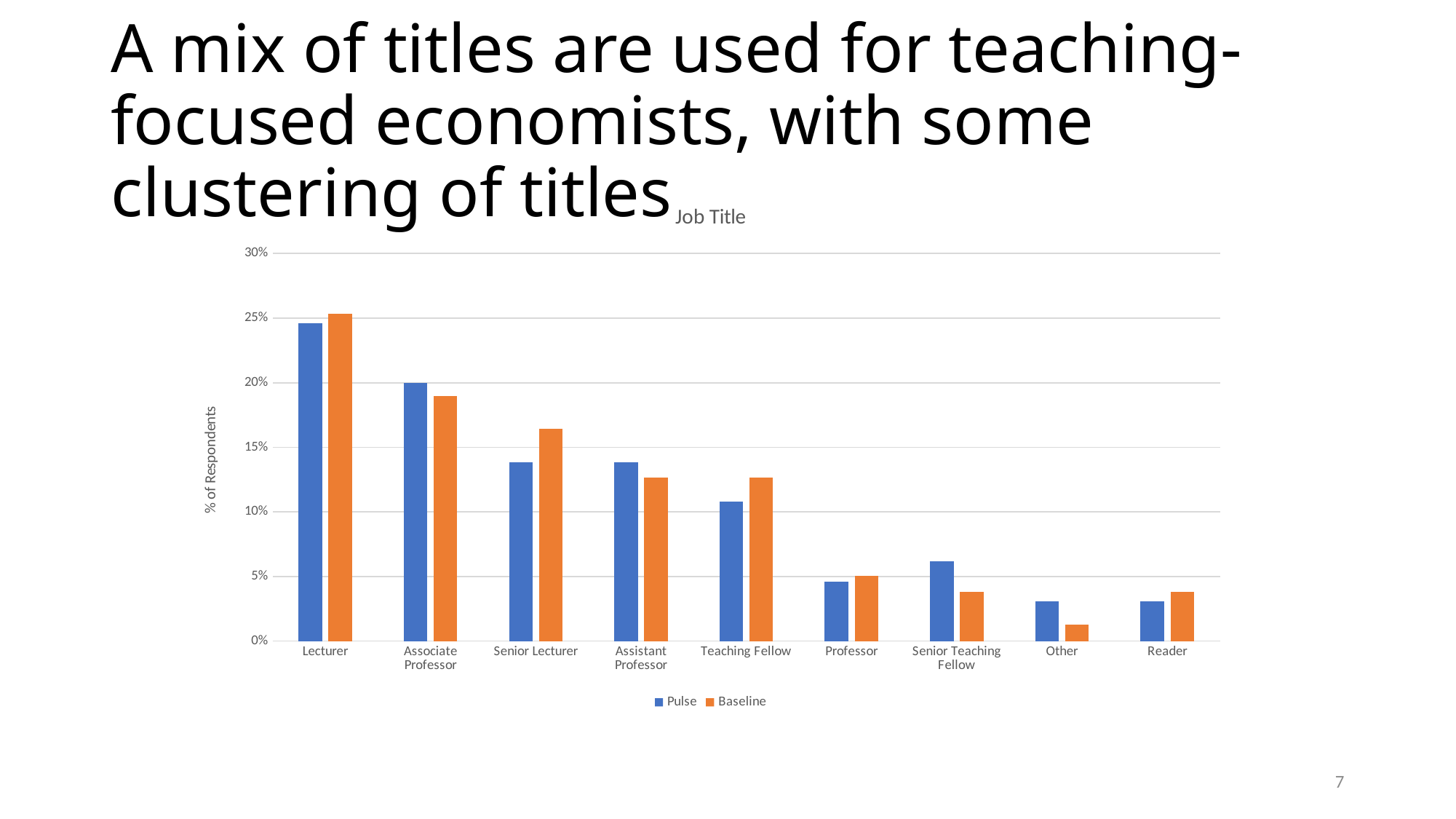
How many job title categories are shown on the x axis? 9 Which job title has the lowest Baseline value? Other Is the Pulse value for Lecturer greater or less than 20%? greater Is the Baseline value for Other greater or less than 5%? less For Senior Lecturer, which series has the larger value, Pulse or Baseline? Baseline Do the Pulse values generally rise or fall moving from left to right along the x axis? Fall How many series does the legend list? 2 What is the label on the vertical axis of the chart? % of Respondents Which job title has the highest Pulse value? Lecturer Is the Baseline value for Senior Lecturer greater or less than 15%? greater For Senior Teaching Fellow, which series has the larger value, Pulse or Baseline? Pulse What kind of chart is shown on the slide? Bar chart